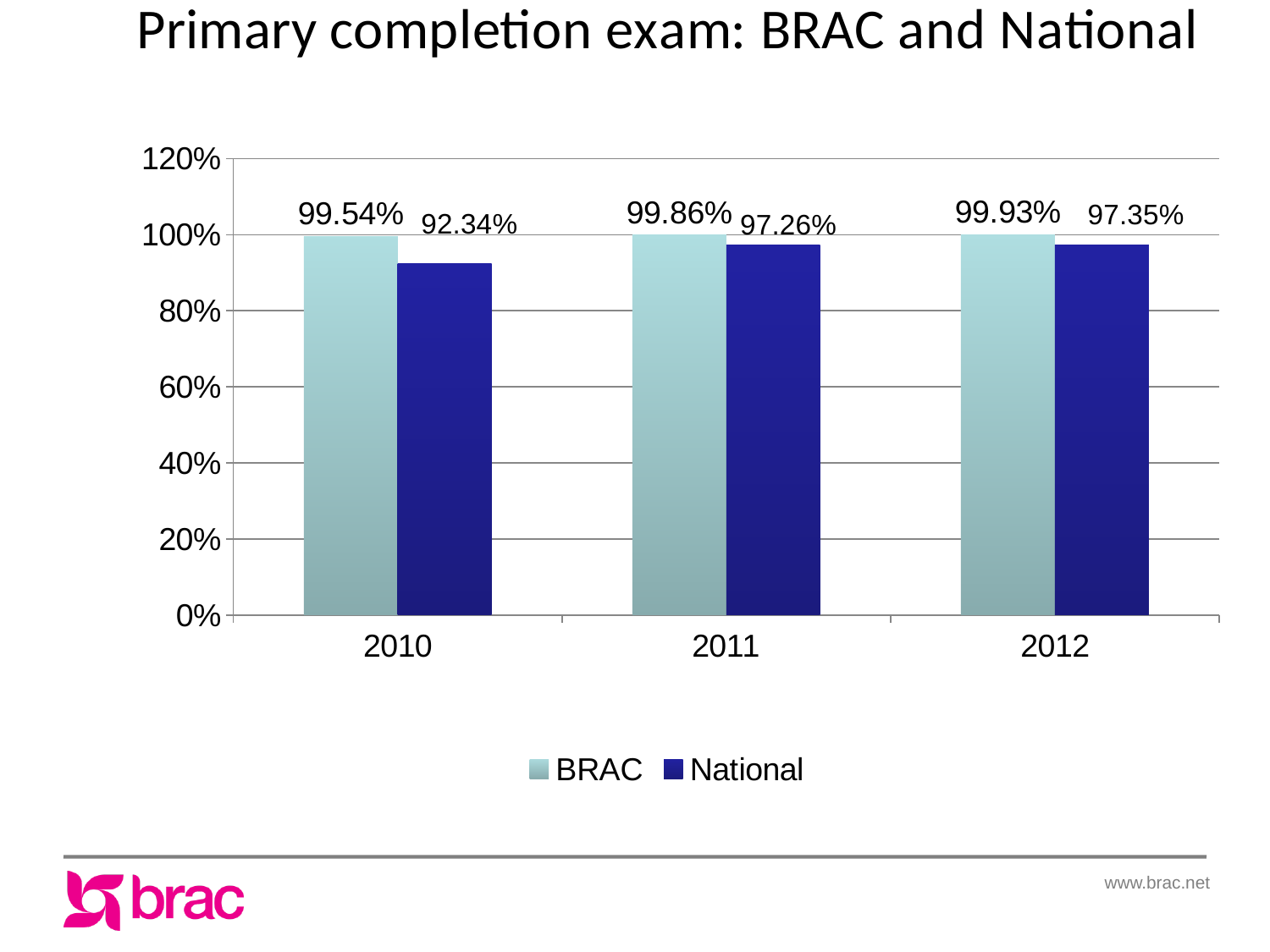
Which is larger in 2012, the BRAC value or the National value? BRAC What is the National value for 2011? 97.26% What kind of chart is shown on the slide? bar chart Is the National value for 2010 greater or less than 100%? less What is the BRAC value for 2010? 99.54% What is the National value for 2012? 97.35% How many series does the legend list? 2 What is the difference between the BRAC and National values in 2011? 2.60% What is the BRAC value for 2012? 99.93% How many years are shown on the x axis? 3 What is the difference between the BRAC and National values in 2010? 7.20% In which year is the National value lowest? 2010